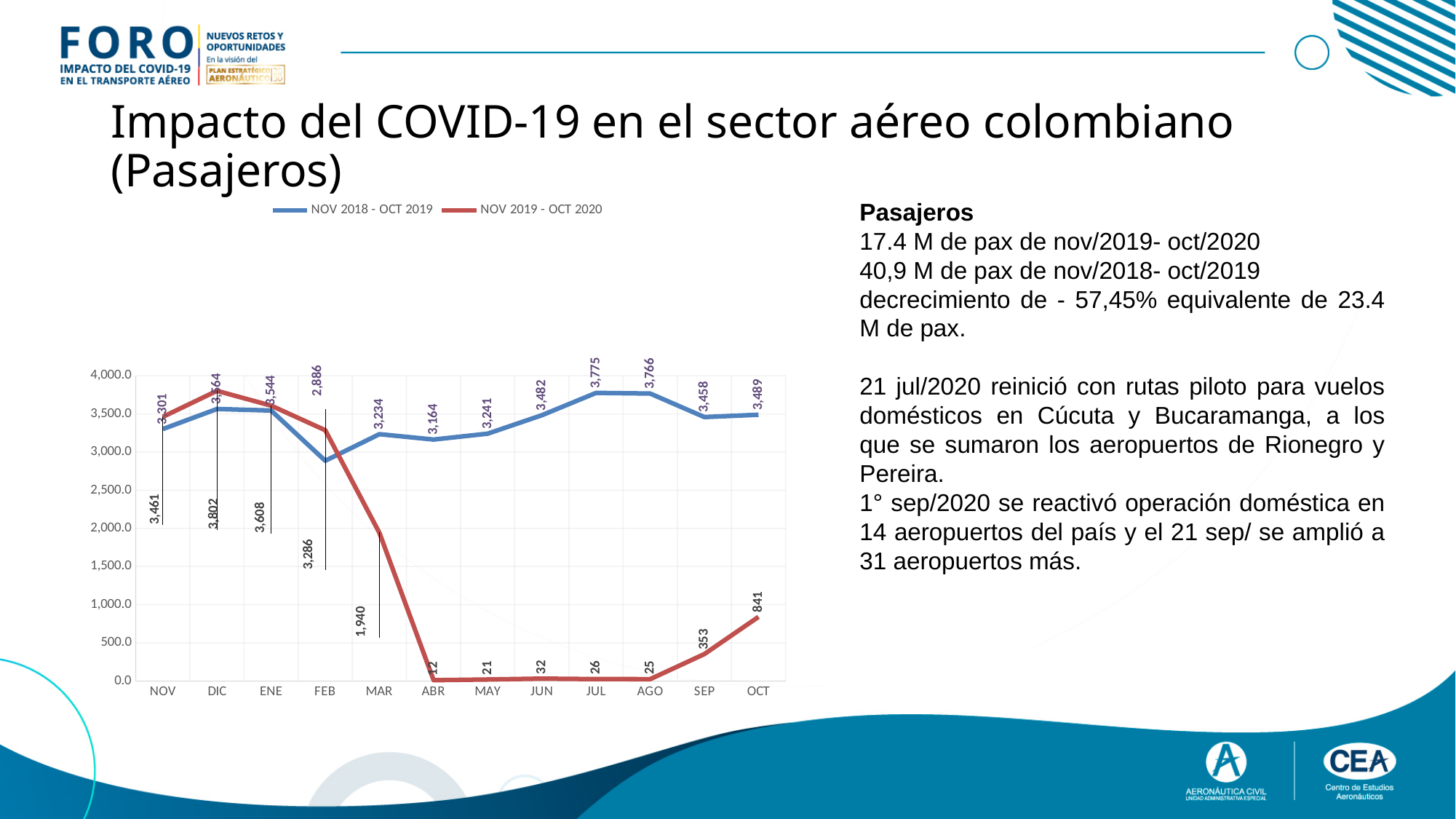
Does the NOV 2019 - OCT 2020 series rise or fall from FEB to ABR? fall Which month has the lowest value in the NOV 2019 - OCT 2020 series? ABR How many series does the chart legend list? 2 Which series has the larger value for FEB, NOV 2018 - OCT 2019 or NOV 2019 - OCT 2020? NOV 2019 - OCT 2020 What is the value for OCT in the NOV 2019 - OCT 2020 series? 841 What is the value for ABR in the NOV 2019 - OCT 2020 series? 12 What is the value for JUL in the NOV 2018 - OCT 2019 series? 3,775 How many months are plotted along the x axis of the chart? 12 Which month has the highest value in the NOV 2019 - OCT 2020 series? DIC What type of chart is shown on the slide? line chart What is the value for MAR in the NOV 2019 - OCT 2020 series? 1,940 What is the difference between the NOV 2018 - OCT 2019 value and the NOV 2019 - OCT 2020 value for SEP? 3,105